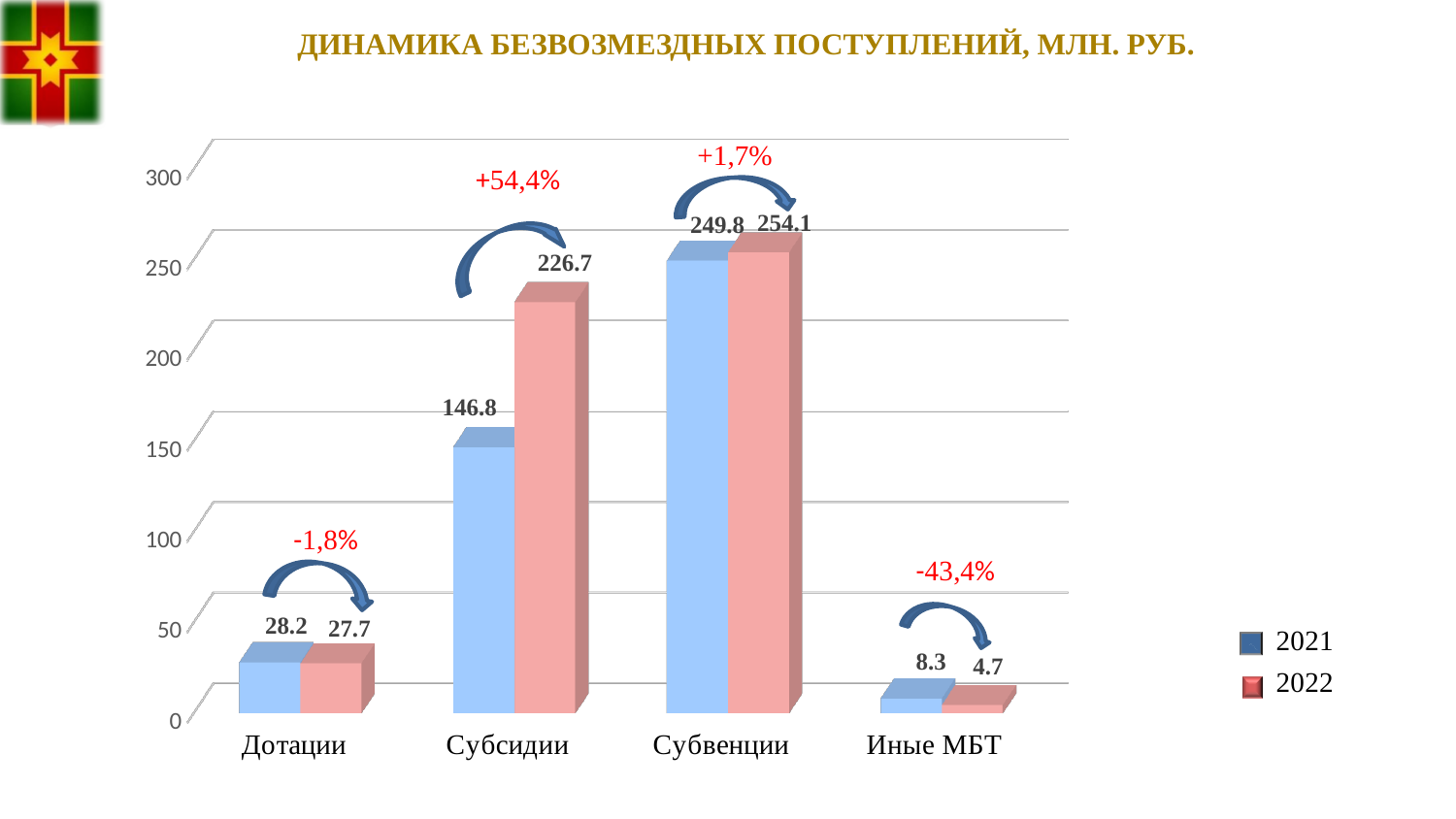
Which category has the highest value in 2022? Субвенции What kind of chart is shown on the slide? Bar chart What is the difference between the 2022 and 2021 values for Субсидии? 79.9 What is the value for Субсидии in 2022? 226.7 Which category has the lowest value in 2021? Иные МБТ What is the value for Иные МБТ in 2022? 4.7 What is the value for Дотации in 2021? 28.2 How many series does the legend list? 2 What is the value for Субвенции in 2021? 249.8 Which is larger for Субвенции: the 2021 value or the 2022 value? 2022 What percentage change is shown above the Иные МБТ bars? -43,4% How many categories are shown on the x axis? 4